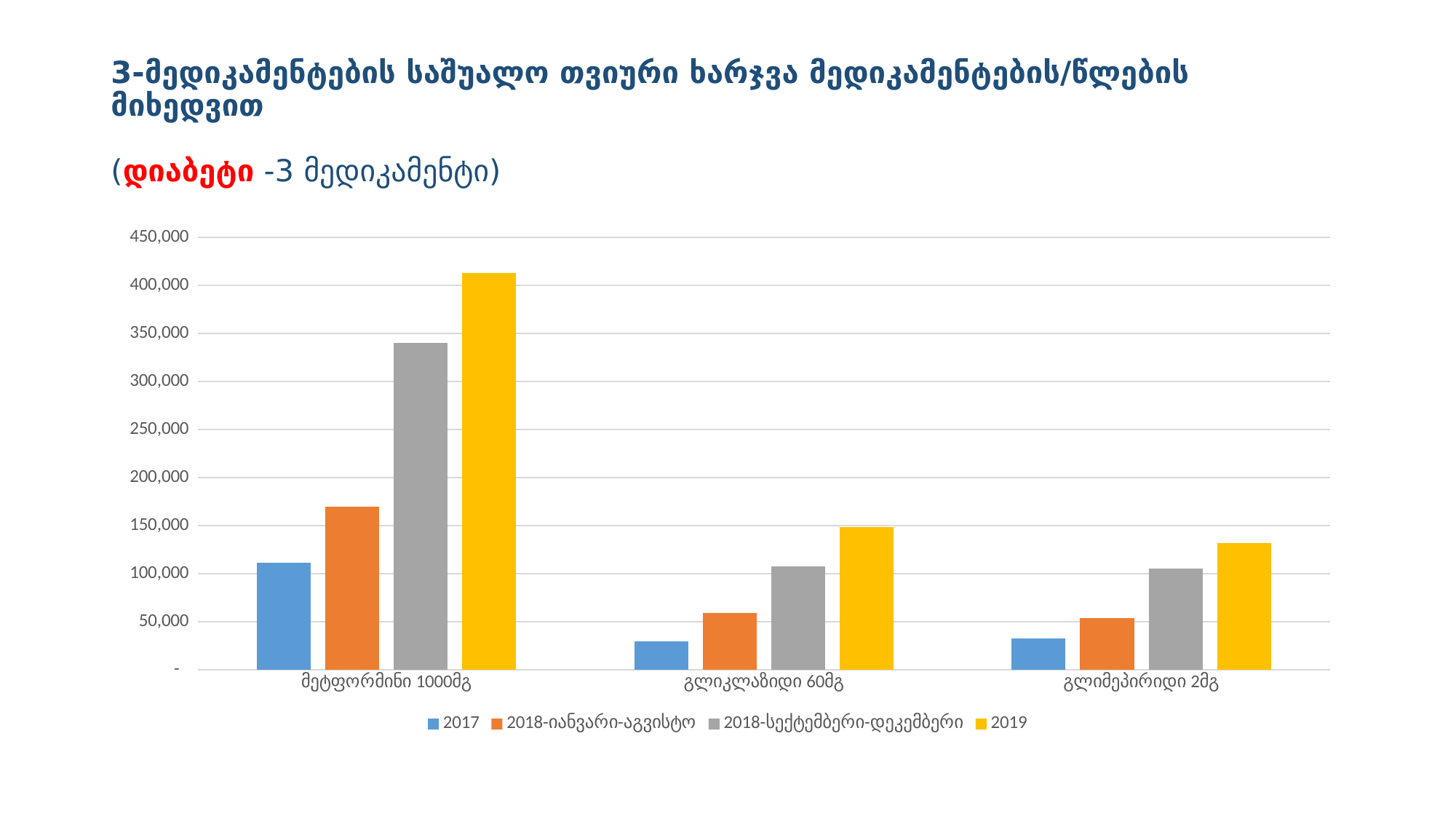
How many medication categories are shown on the x axis? 3 How many series does the legend list? 4 Which medication has the highest value for the 2019 series? მეტფორმინი 1000მგ Which is larger for the 2019 series: გლიკლაზიდი 60მგ or გლიმეპირიდი 2მგ? გლიკლაზიდი 60მგ For მეტფორმინი 1000მგ, do the values rise or fall from the 2017 series to the 2019 series? rise What kind of chart is shown on the slide? bar chart Is the 2017 value for გლიმეპირიდი 2მგ greater or less than 50,000? less What colour are the bars for the 2019 series? yellow Is the 2019 value for გლიკლაზიდი 60მგ greater or less than 100,000? greater Which medication has the lowest value for the 2019 series? გლიმეპირიდი 2მგ Is the 2019 value for მეტფორმინი 1000მგ greater or less than 400,000? greater